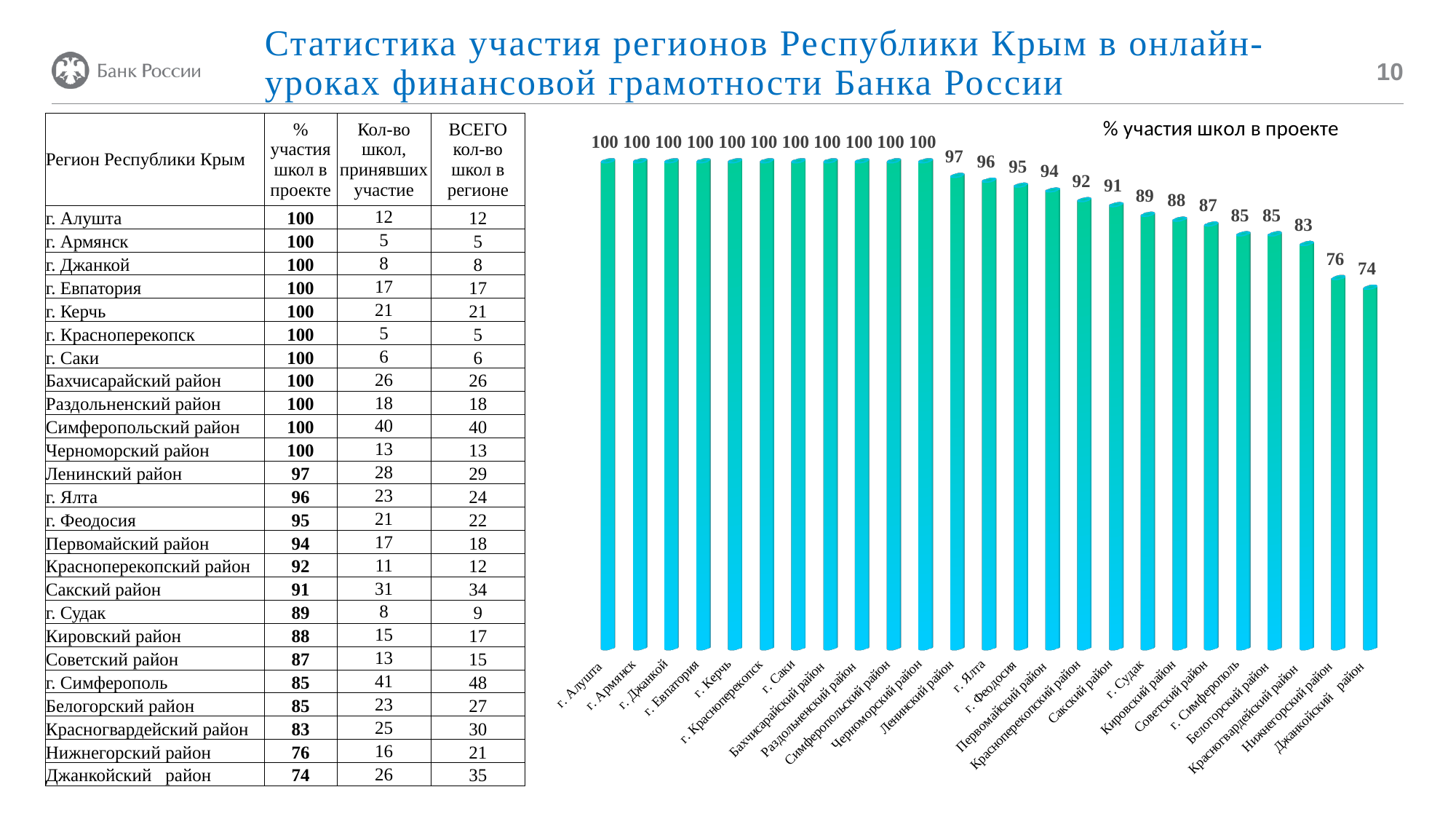
Which category has the lowest value in the chart? Джанкойский район What is the value for Нижнегорский район in the chart? 76 What is the value for Ленинский район in the chart? 97 What kind of chart is shown on the slide? bar chart What is the difference between the values for Сакский район and Красногвардейский район? 8 Do the values rise or fall from left to right along the x axis? fall What is the difference between the values for г. Ялта and Джанкойский район? 22 What is the title of the chart? % участия школ в проекте What is the value for г. Судак in the chart? 89 How many categories are plotted in the chart? 25 Which is larger: the value for Кировский район or the value for Белогорский район? Кировский район What is the value for г. Феодосия in the chart? 95